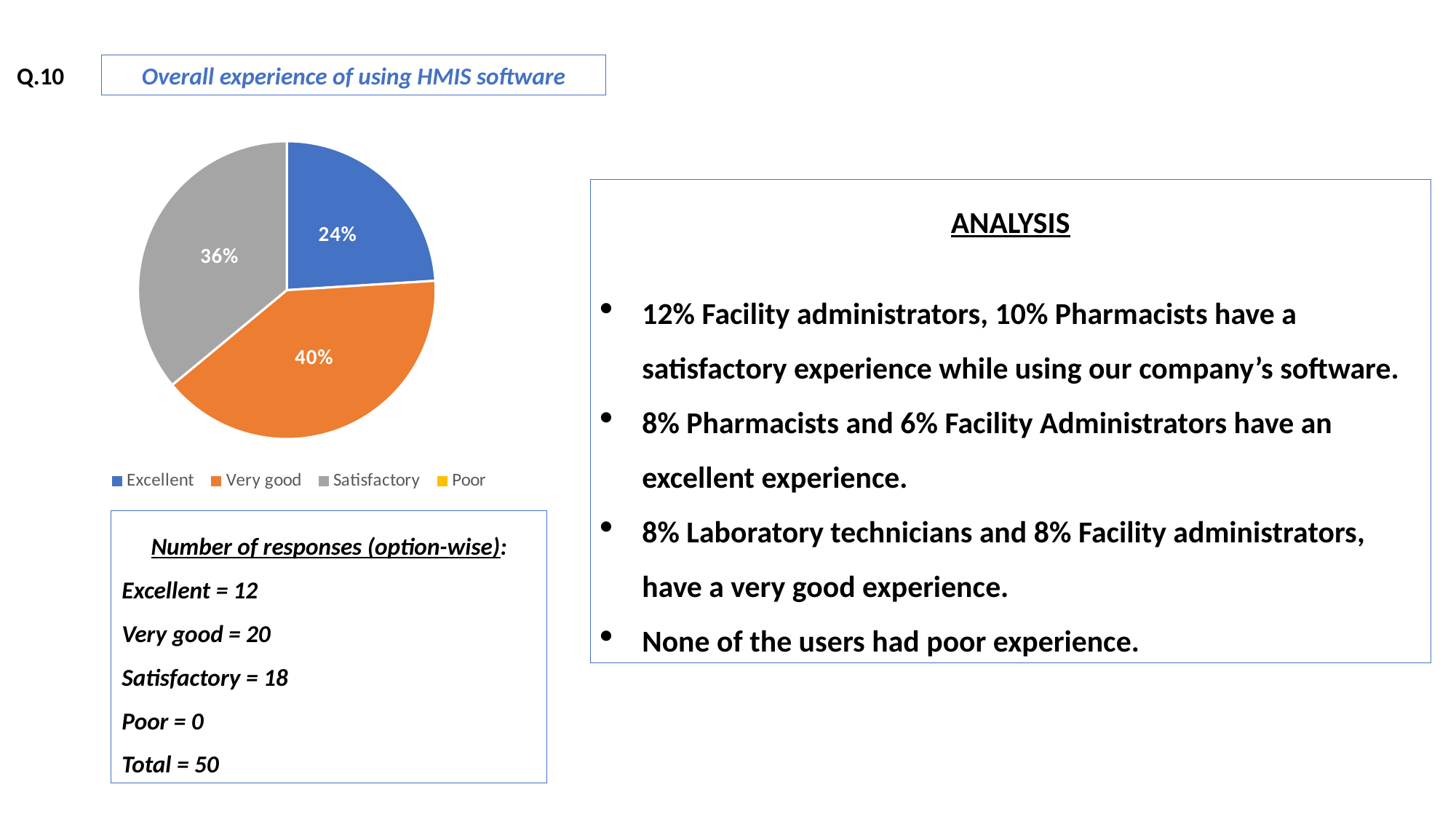
What percentage of the pie does the Excellent slice represent? 24% Which category has the smallest share among the slices visible in the pie? Excellent What percentage of the pie does the Satisfactory slice represent? 36% What colour is the Very good slice? Orange What type of chart is shown on the slide? Pie chart Which category has the largest share of the pie? Very good Which legend category has no visible slice in the pie? Poor How many categories does the legend list? 4 What is the difference in percentage points between the Very good and Excellent slices? 16% Which slice is larger, Satisfactory or Excellent? Satisfactory What percentage of the pie does the Very good slice represent? 40% What is the difference in percentage points between the Very good and Satisfactory slices? 4%